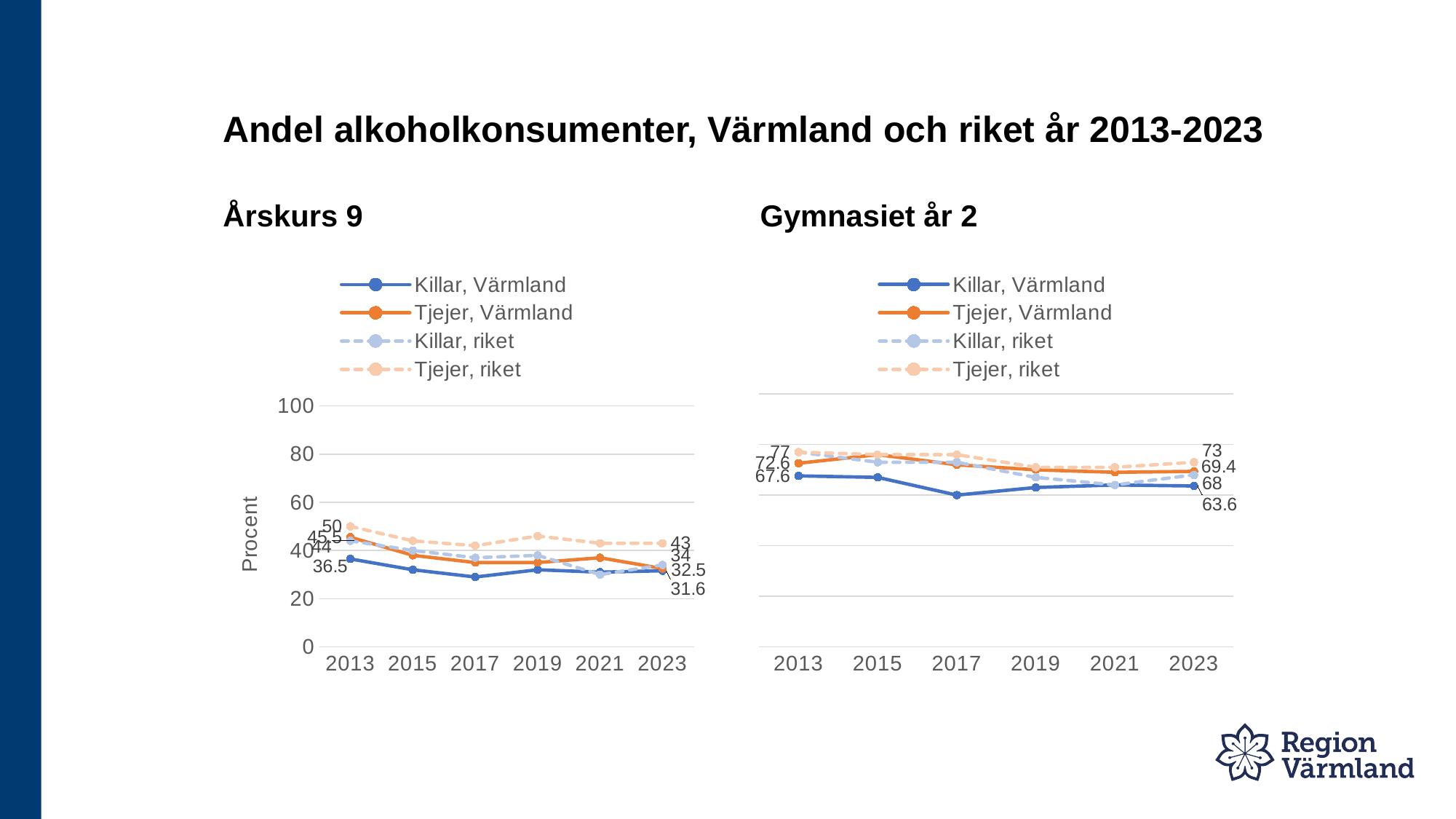
In the Årskurs 9 chart, by how much did the value for Tjejer, riket fall from 2013 to 2023? 7 How many series does the legend of the Gymnasiet år 2 chart list? 4 In the Årskurs 9 chart, which series has the highest value in 2013? Tjejer, riket In the Årskurs 9 chart, what is the value for Tjejer, riket in 2013? 50 In the Årskurs 9 chart, is the value for Tjejer, riket in 2019 greater or less than 40? greater How many years are shown on the x axis of the Årskurs 9 chart? 6 In the Gymnasiet år 2 chart, what is the value for Tjejer, riket in 2023? 73 In the Gymnasiet år 2 chart, what is the value for Killar, Värmland in 2013? 67.6 What type of chart is used for the Årskurs 9 data? Line chart In the Gymnasiet år 2 chart, what is the difference between the Killar, Värmland values in 2013 and 2023? 4 In the Årskurs 9 chart, what is the value for Killar, Värmland in 2023? 31.6 In the Gymnasiet år 2 chart, which is larger in 2023: Tjejer, riket or Killar, Värmland? Tjejer, riket